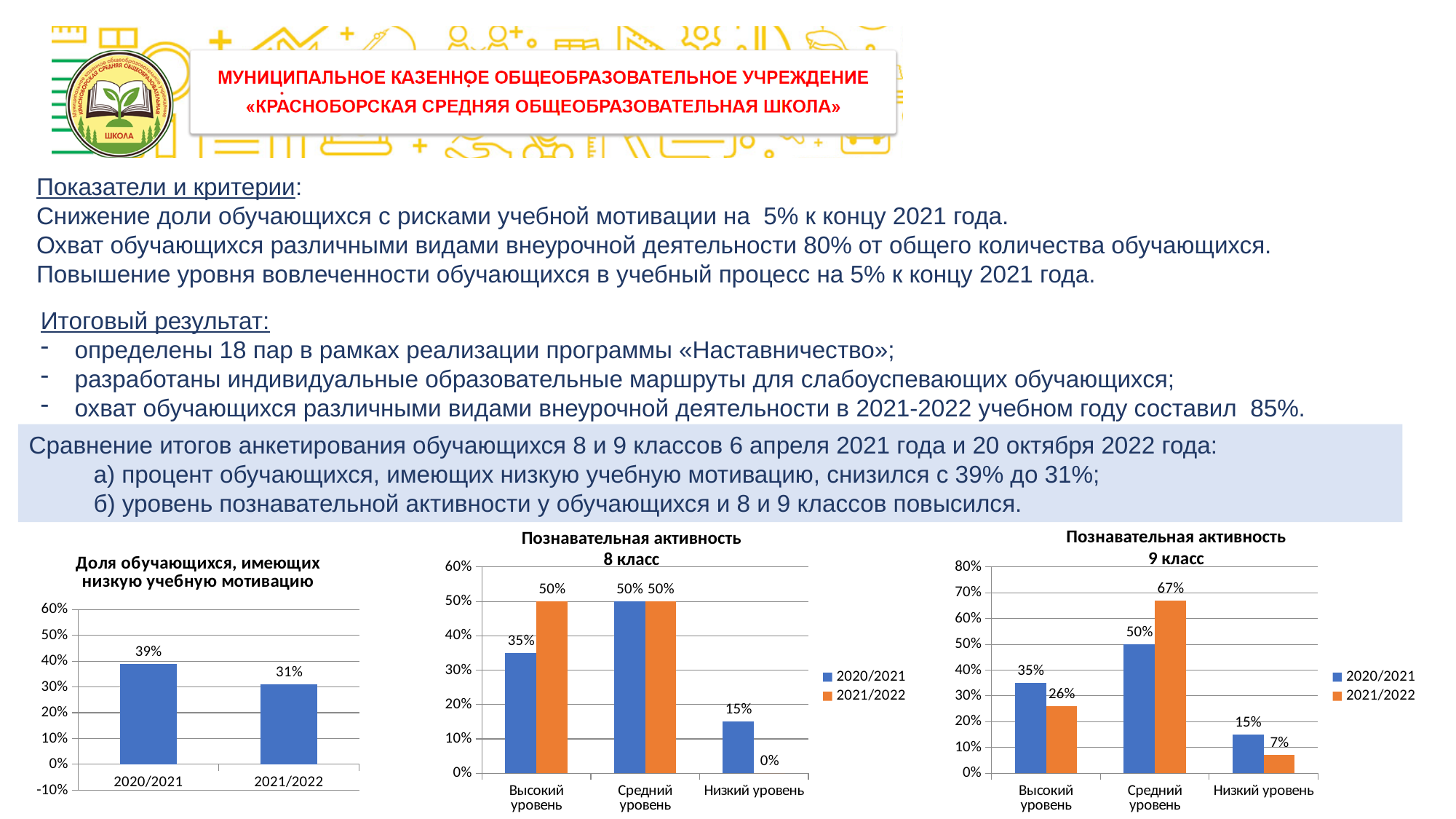
In the chart 'Познавательная активность 8 класс', which category has the lowest 2020/2021 value? Низкий уровень In the chart 'Познавательная активность 9 класс', how many categories are shown on the x axis? 3 In the chart 'Познавательная активность 8 класс', what is the 2021/2022 value for Низкий уровень? 0% In the chart 'Познавательная активность 9 класс', what is the difference between the 2021/2022 and 2020/2021 values for Средний уровень? 17% In the chart 'Познавательная активность 8 класс', what is the 2021/2022 value for Высокий уровень? 50% In the chart 'Доля обучающихся, имеющих низкую учебную мотивацию', do the values rise or fall from 2020/2021 to 2021/2022? fall In the chart 'Доля обучающихся, имеющих низкую учебную мотивацию', what is the difference between the 2020/2021 and 2021/2022 values? 8% What type of chart is 'Познавательная активность 9 класс'? bar chart In the chart 'Познавательная активность 9 класс', what is the 2021/2022 value for Средний уровень? 67% In the chart 'Доля обучающихся, имеющих низкую учебную мотивацию', what is the value for 2020/2021? 39% In the chart 'Познавательная активность 8 класс', how many series does the legend list? 2 In the chart 'Познавательная активность 9 класс', which is larger for Высокий уровень: the 2020/2021 value or the 2021/2022 value? 2020/2021